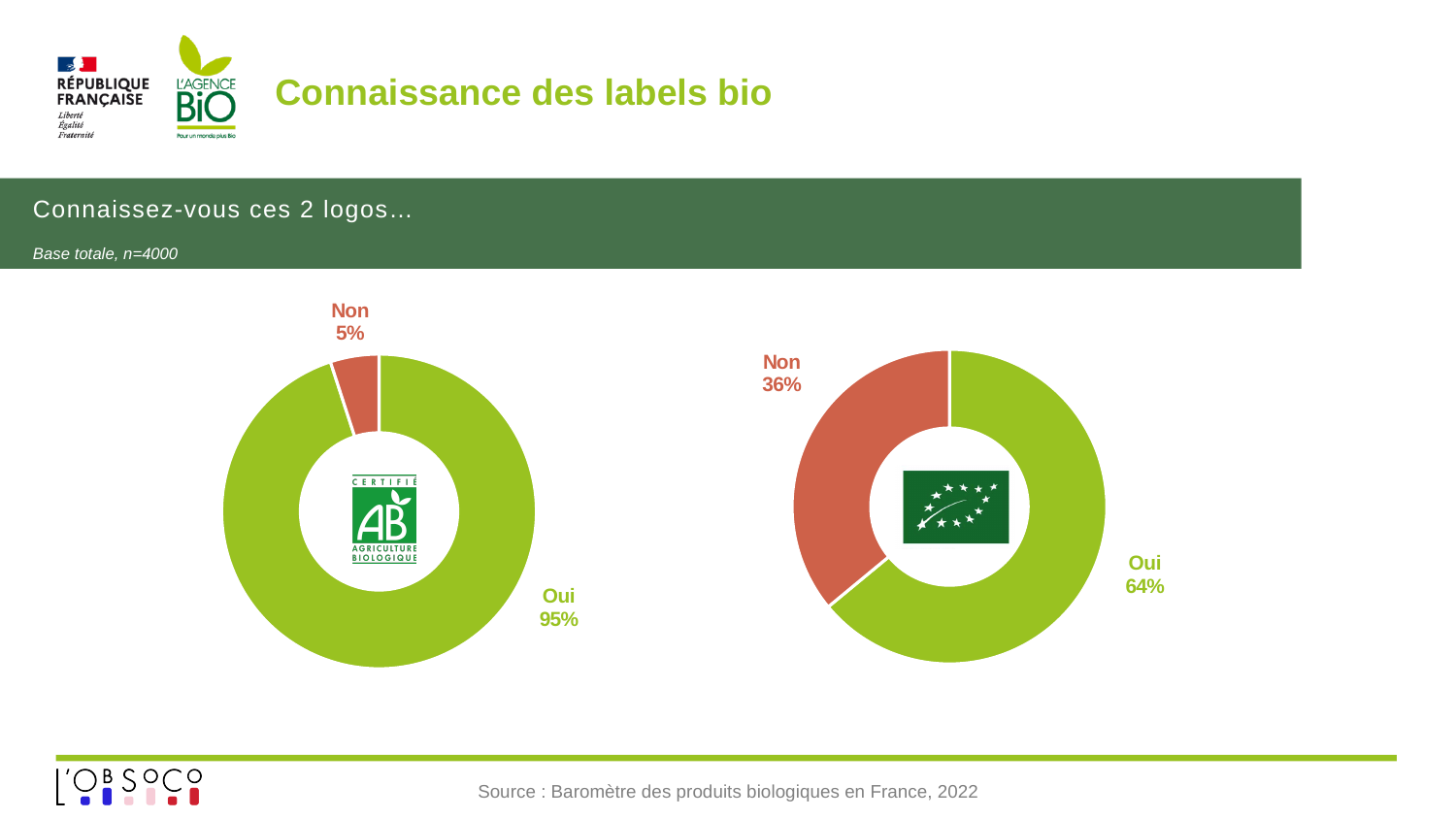
What kind of chart is used on this slide? Doughnut (pie) chart In the right chart (EU organic leaf logo), what percentage of respondents answered "Oui"? 64% In the right chart (EU organic leaf logo), what is the difference between the "Oui" and "Non" shares? 28 percentage points Which chart has the larger "Non" share, the left chart (AB logo) or the right chart (EU organic leaf logo)? The right chart (EU organic leaf logo) In the left chart (AB logo), what percentage of respondents answered "Non"? 5% In the right chart (EU organic leaf logo), what percentage of respondents answered "Non"? 36% How many categories are shown in each doughnut chart? 2 In the left chart (AB logo), what percentage of respondents answered "Oui"? 95% What colour represents the "Oui" answer in both charts? Green What is the difference between the "Oui" shares of the left chart (AB logo) and the right chart (EU organic leaf logo)? 31 percentage points In the left chart (AB logo), which answer has the largest share? Oui In the right chart (EU organic leaf logo), which answer has the smallest share? Non